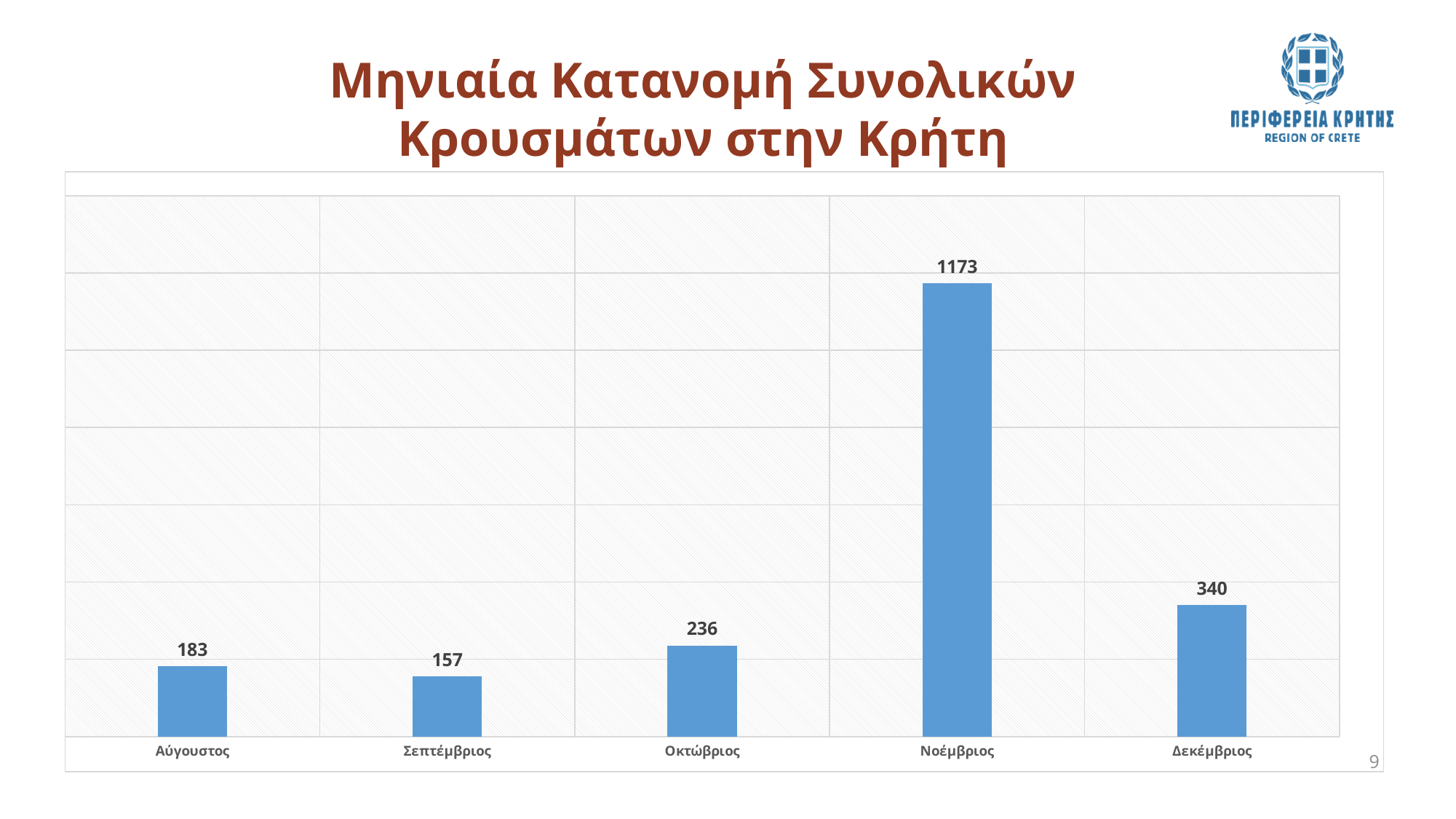
What is the title of the slide? Μηνιαία Κατανομή Συνολικών Κρουσμάτων στην Κρήτη What is the difference between the values for Οκτώβριος and Σεπτέμβριος? 79 Which is larger, the value for Αύγουστος or the value for Σεπτέμβριος? Αύγουστος What is the difference between the values for Νοέμβριος and Δεκέμβριος? 833 What is the value for Νοέμβριος? 1173 What kind of chart is shown on the slide? Bar chart Which month has the lowest value? Σεπτέμβριος What is the value for Δεκέμβριος? 340 Which month has the highest value? Νοέμβριος What is the value for Αύγουστος? 183 How many months are shown on the chart? 5 Do the values rise or fall from Οκτώβριος to Νοέμβριος? Rise